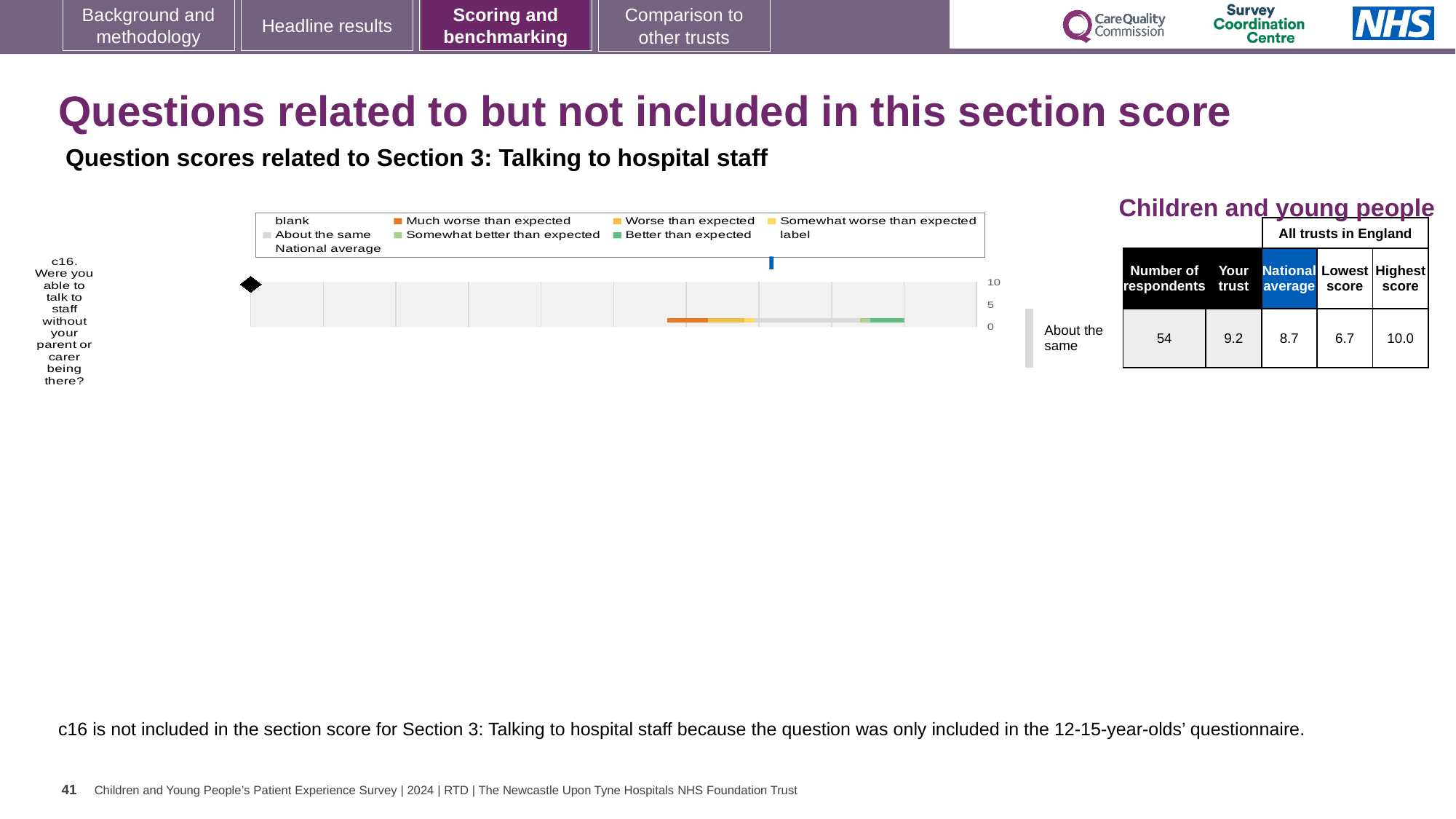
What is the difference between the trust's score (9.2) and the National average (8.7) for c16? 0.5 In the table beside the chart, what is the 'Your trust' score for c16? 9.2 In the table beside the chart, what is the Lowest score across all trusts in England for c16? 6.7 In the table beside the chart, what is the National average score for c16? 8.7 Is the trust's score for c16 (9.2) larger or smaller than the National average (8.7)? larger How many question categories are plotted on the chart? 1 What kind of chart is shown on the slide? bar chart In the table beside the chart, what is the Highest score across all trusts in England for c16? 10.0 In the table beside the chart, how many respondents answered c16? 54 What is the highest value shown on the chart's axis? 10 According to the label next to the chart, how does the trust's result for c16 compare to expected? About the same Which question is plotted on the chart? c16. Were you able to talk to staff without your parent or carer being there?